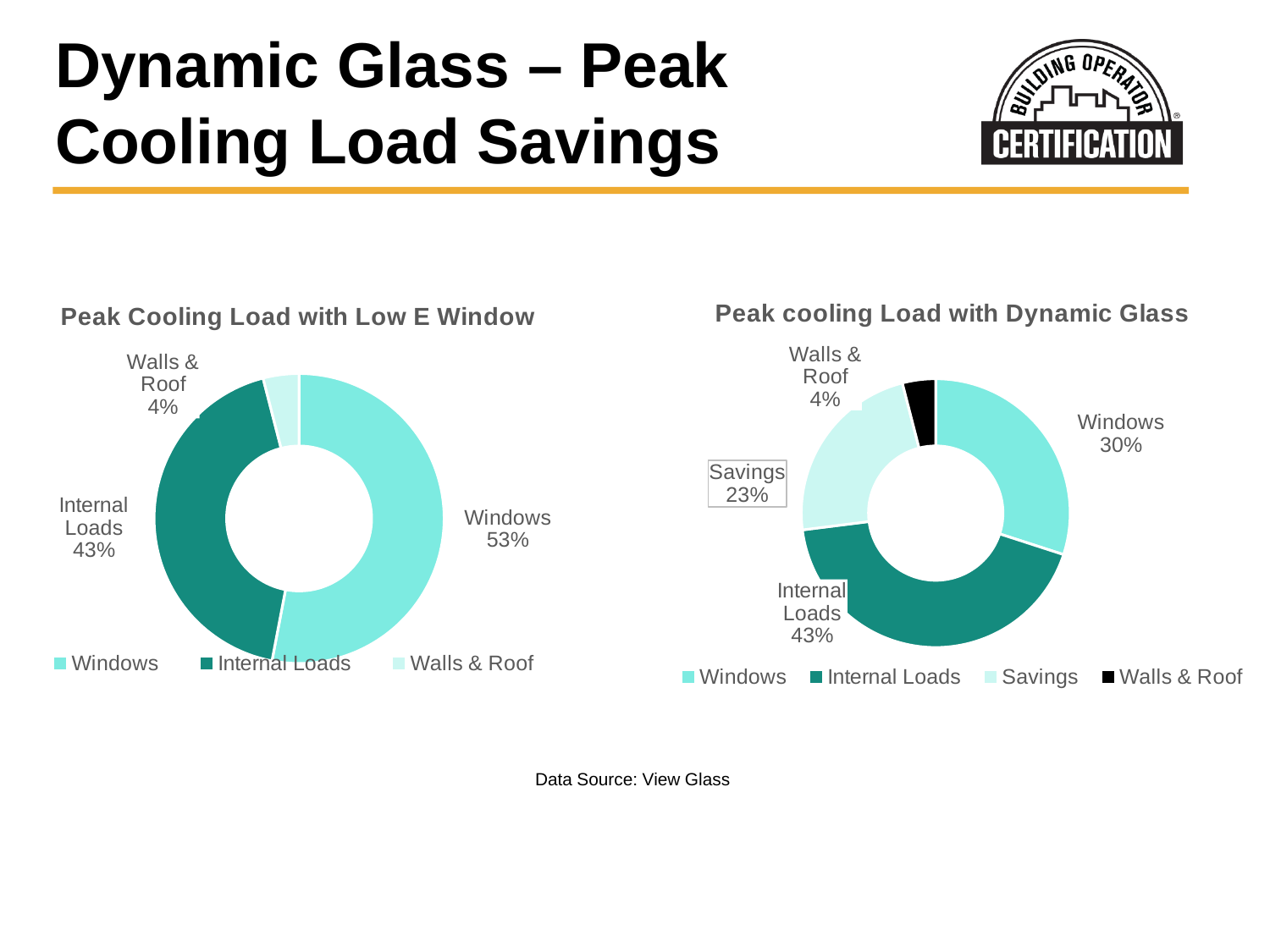
In the 'Peak cooling Load with Dynamic Glass' chart, what share is Windows? 30% In the 'Peak cooling Load with Dynamic Glass' chart, what share is Savings? 23% In the 'Peak Cooling Load with Low E Window' chart, what share is Internal Loads? 43% How many categories does the legend of the 'Peak Cooling Load with Low E Window' chart list? 3 In the 'Peak Cooling Load with Low E Window' chart, what share is Windows? 53% In the 'Peak cooling Load with Dynamic Glass' chart, which category has the smallest share? Walls & Roof What type of chart is the 'Peak Cooling Load with Low E Window' chart? Doughnut (pie) chart How many categories does the legend of the 'Peak cooling Load with Dynamic Glass' chart list? 4 In the 'Peak cooling Load with Dynamic Glass' chart, which is larger, Windows or Savings? Windows What is the difference between the Windows share in the Low E Window chart and the Windows share in the Dynamic Glass chart? 23% In the 'Peak cooling Load with Dynamic Glass' chart, which category has the largest share? Internal Loads In the 'Peak Cooling Load with Low E Window' chart, which category has the largest share? Windows